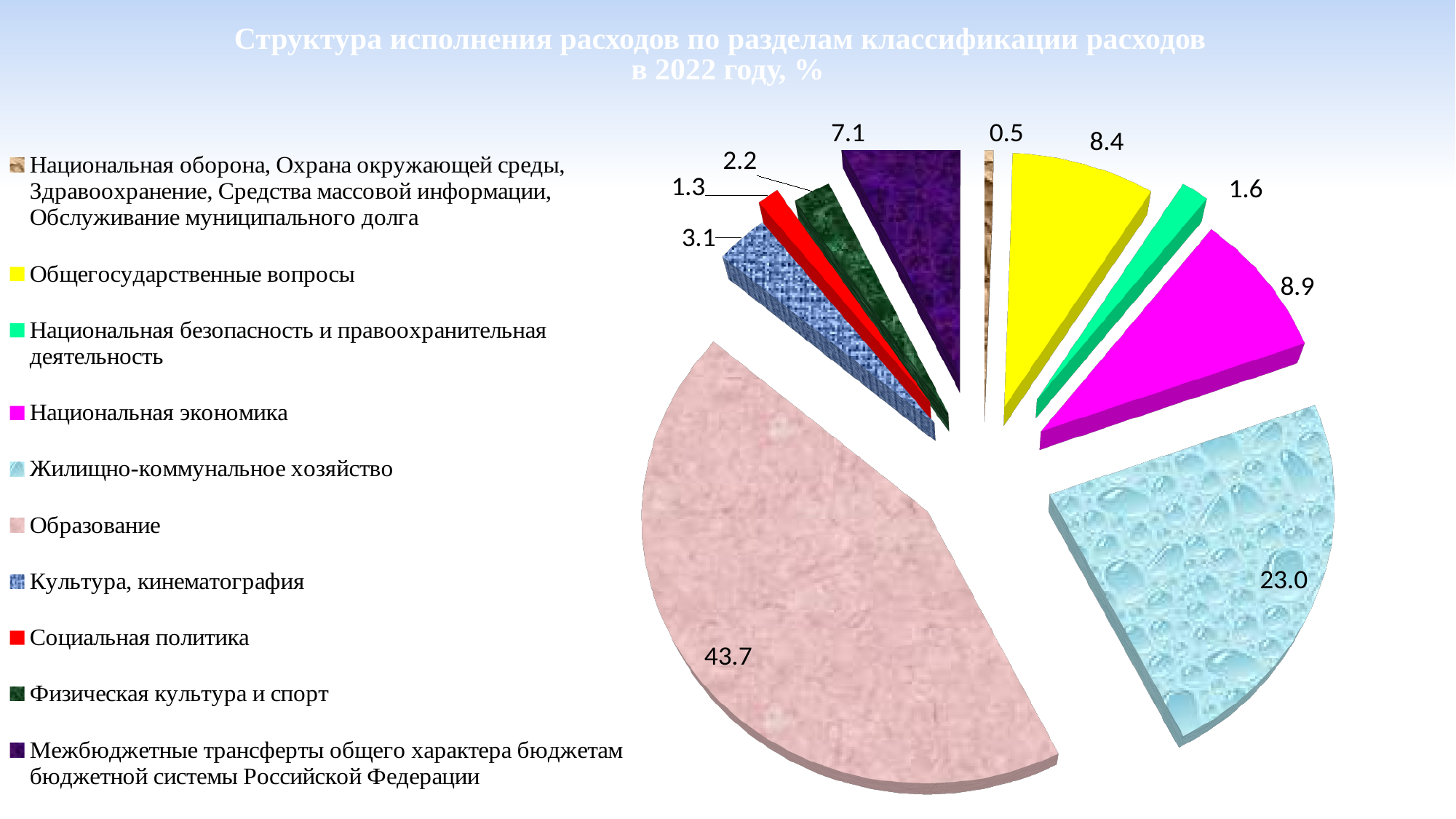
Which category has the smallest share of the pie? Национальная оборона, Охрана окружающей среды, Здравоохранение, Средства массовой информации, Обслуживание муниципального долга What is the value for Общегосударственные вопросы? 8.4 What is the value for Национальная экономика? 8.9 What is the difference between the values for Образование and Жилищно-коммунальное хозяйство? 20.7 What kind of chart is shown on the slide? pie chart What is the value for Межбюджетные трансферты общего характера бюджетам бюджетной системы Российской Федерации? 7.1 Which is larger, the value for Культура, кинематография or the value for Социальная политика? Культура, кинематография What is the value for Образование? 43.7 Which category has the largest share of the pie? Образование What is the title of the chart? Структура исполнения расходов по разделам классификации расходов в 2022 году, % What is the value for Жилищно-коммунальное хозяйство? 23.0 How many categories does the pie chart have? 10